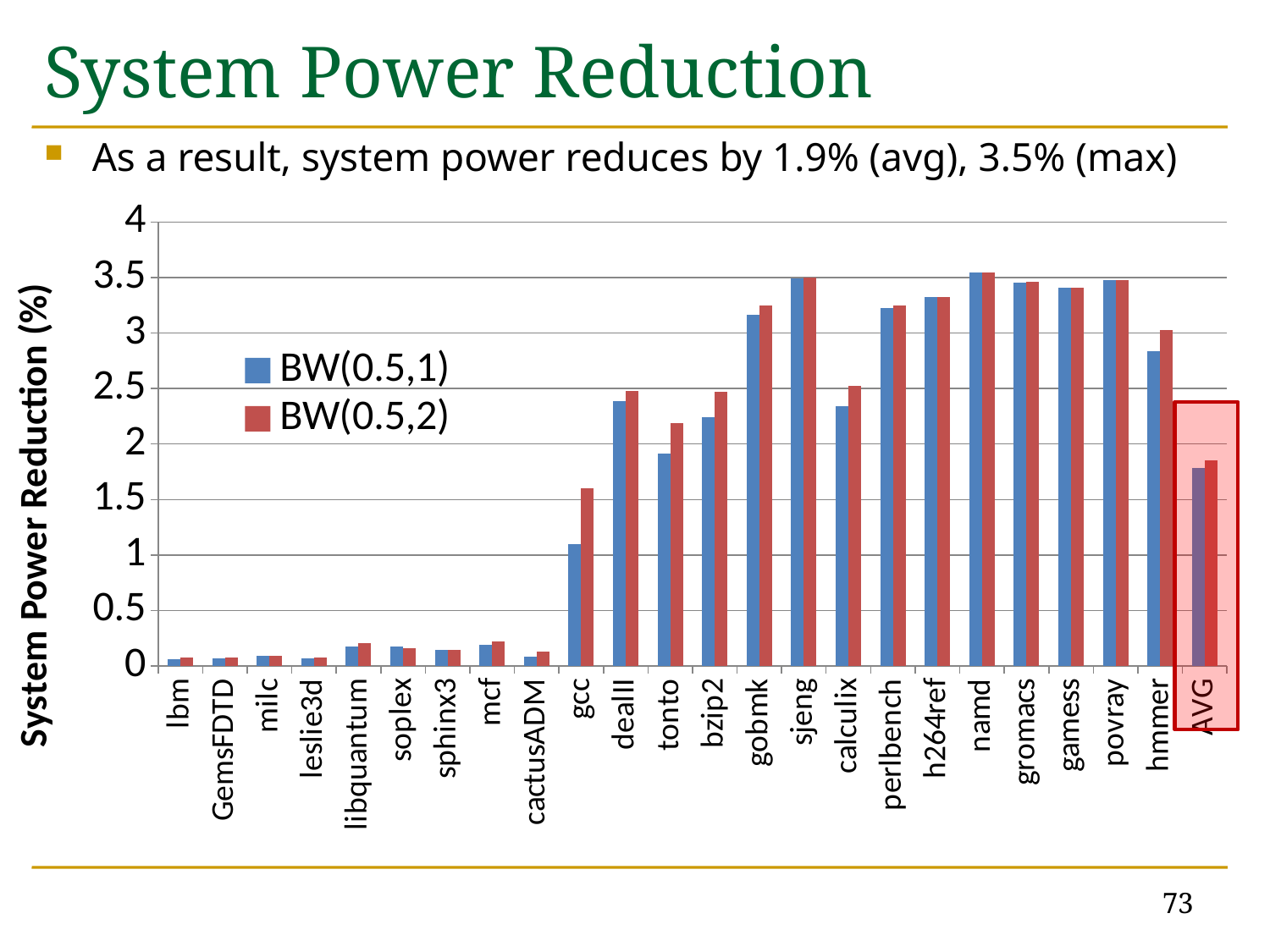
What kind of chart is shown on the slide? bar chart Is the BW(0.5,2) value for AVG greater or less than 2? less Which category is highlighted with a red box? AVG For gcc, which series has the larger value, BW(0.5,1) or BW(0.5,2)? BW(0.5,2) What is the label of the y axis? System Power Reduction (%) Is the BW(0.5,1) value for tonto greater or less than 2? less Is the BW(0.5,1) value for hmmer greater or less than 3? less Which has the larger BW(0.5,1) value, gcc or dealII? dealII How many categories are plotted along the x axis? 24 How many series does the legend list? 2